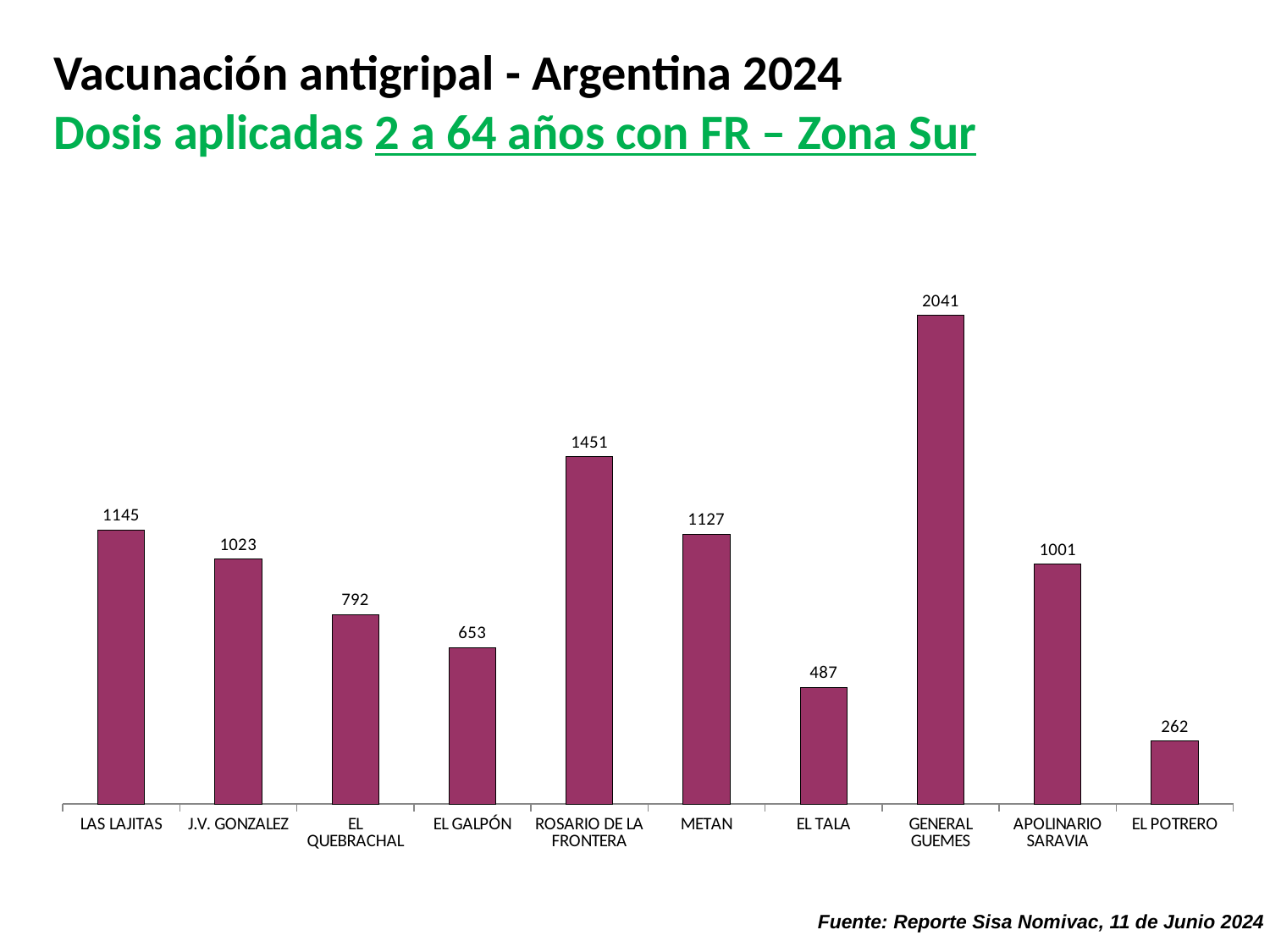
How many categories are shown on the x axis? 10 What is the difference between the values for LAS LAJITAS and J.V. GONZALEZ? 122 What is the value for GENERAL GUEMES? 2041 Which category has the lowest value? EL POTRERO Which is larger, the value for EL QUEBRACHAL or the value for EL TALA? EL QUEBRACHAL Which category has the highest value? GENERAL GUEMES What is the total of the values for EL TALA and EL POTRERO? 749 What is the difference between the values for ROSARIO DE LA FRONTERA and METAN? 324 What is the value for APOLINARIO SARAVIA? 1001 What kind of chart is shown on the slide? bar chart What is the value for EL GALPÓN? 653 What is the source cited at the bottom of the slide? Reporte Sisa Nomivac, 11 de Junio 2024